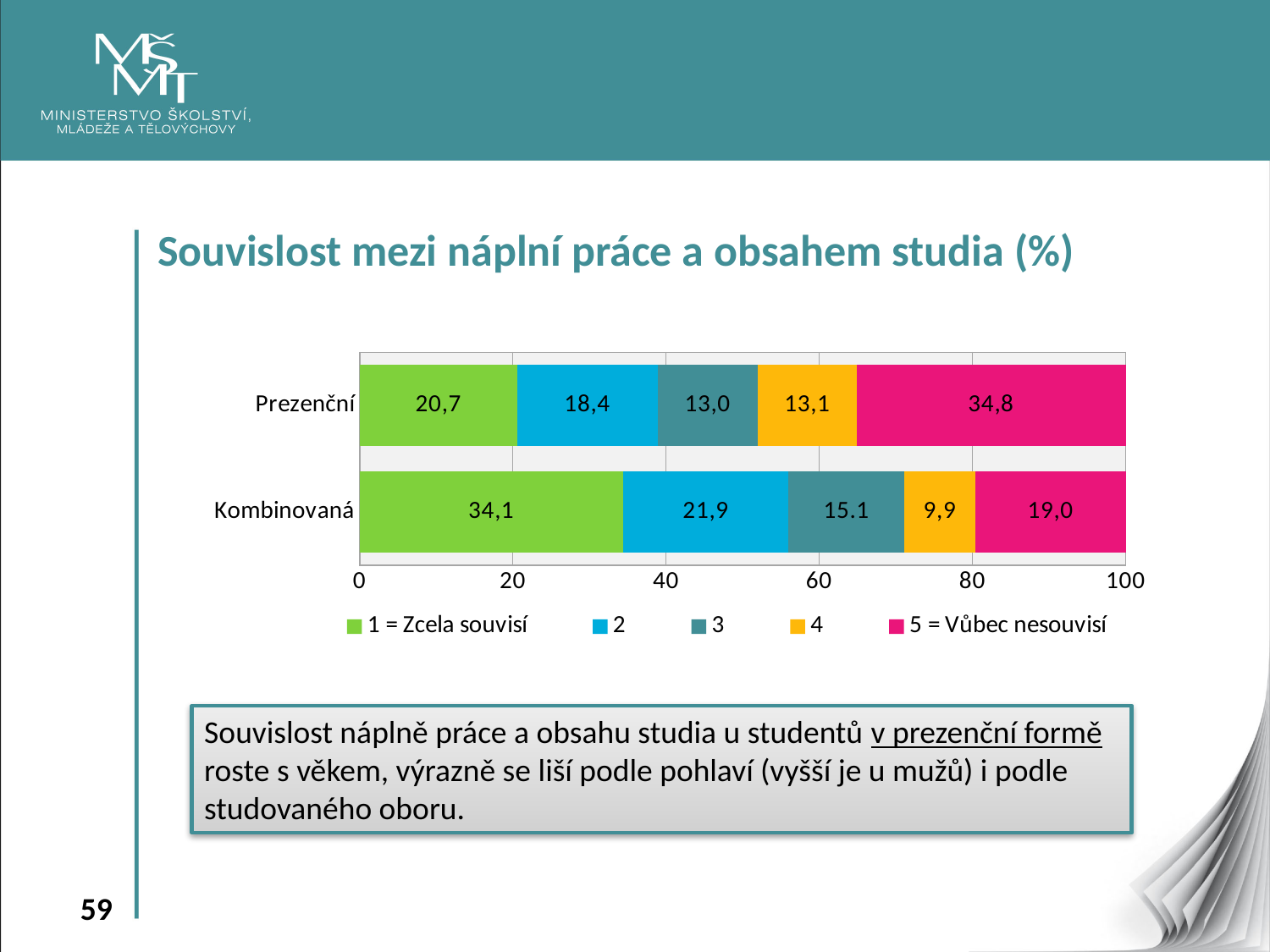
What is the title of the chart? Souvislost mezi náplní práce a obsahem studia (%) Which series has the smallest value in the Kombinovaná bar? 4 Which series has the largest value in the Prezenční bar? 5 = Vůbec nesouvisí What is the value for series "4" in the Prezenční bar? 13,1 How many series does the legend list? 5 What kind of chart is shown on the slide? Stacked bar chart What is the value for series "5 = Vůbec nesouvisí" in the Kombinovaná bar? 19,0 What is the difference between the "1 = Zcela souvisí" values for Kombinovaná and Prezenční? 13,4 Which category has the larger value for series "2", Prezenční or Kombinovaná? Kombinovaná What is the value for series "1 = Zcela souvisí" in the Prezenční bar? 20,7 How many categories are shown on the y axis? 2 What is the value for series "3" in the Kombinovaná bar? 15.1